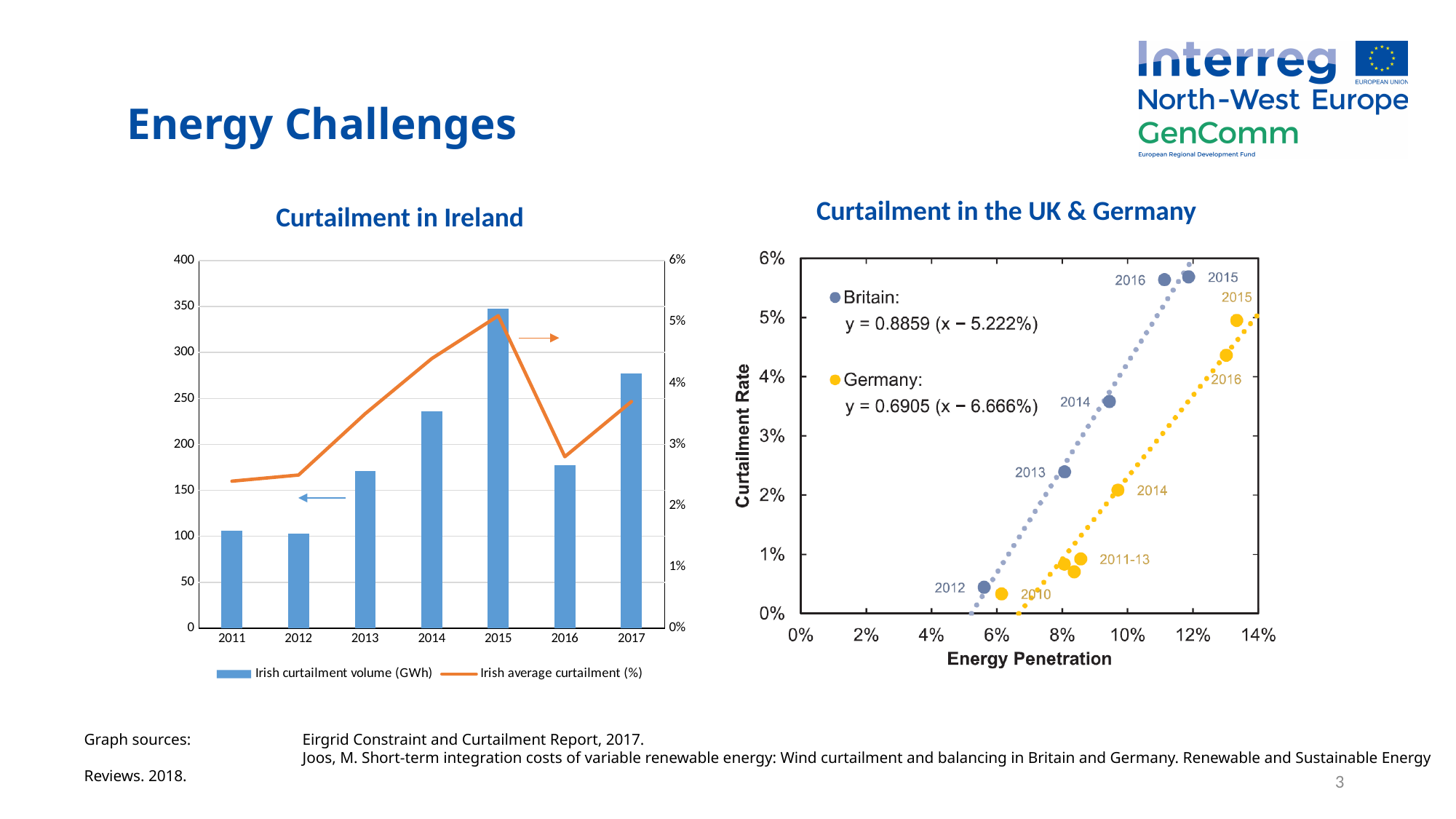
On the Curtailment in the UK & Germany chart, what is the fitted equation shown for Britain? y = 0.8859 (x − 5.222%) On the Curtailment in Ireland chart, how many series does the legend list? 2 On the Curtailment in Ireland chart, how many years are shown on the x axis? 7 On the Curtailment in Ireland chart, does the Irish average curtailment (%) rise or fall from 2011 to 2015? rise On the Curtailment in the UK & Germany chart, is the curtailment rate for Britain in 2015 greater or less than 5%? greater On the Curtailment in Ireland chart, is the Irish curtailment volume for 2011 greater or less than 150? less What kind of chart is the Curtailment in the UK & Germany chart? scatter chart On the Curtailment in the UK & Germany chart, which has the higher curtailment rate in 2014, Britain or Germany? Britain On the Curtailment in Ireland chart, which is larger, the Irish curtailment volume for 2017 or for 2014? 2017 On the Curtailment in Ireland chart, is the Irish average curtailment (%) for 2014 greater or less than 4%? greater On the Curtailment in Ireland chart, which year has the highest Irish curtailment volume (GWh)? 2015